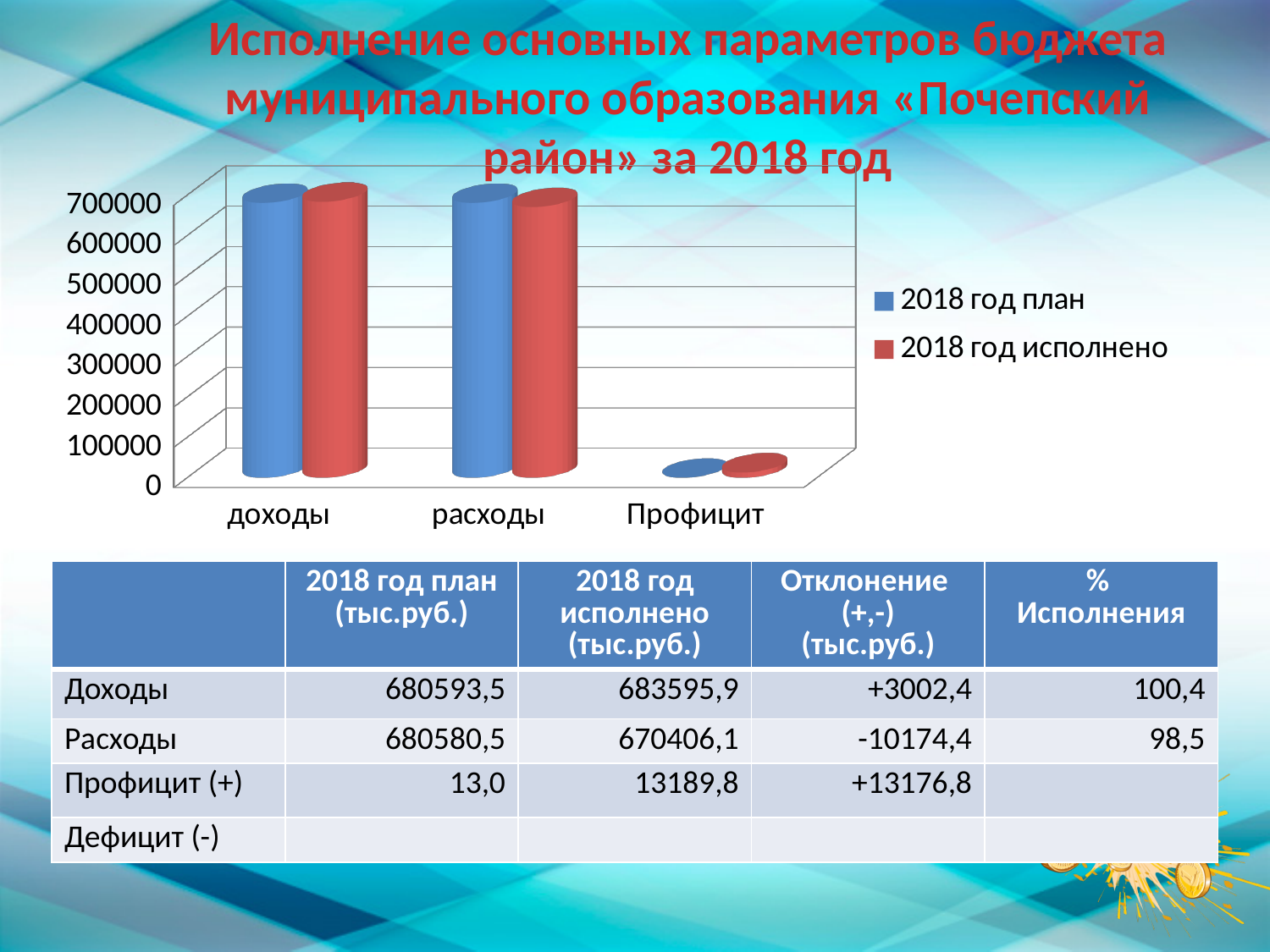
Which category has the lowest values in the chart? Профицит What colour are the bars for the series 2018 год исполнено? red Which is larger in the chart: the 2018 год план value for расходы or for Профицит? расходы How many series does the chart legend list? 2 According to the table on the slide, what is the 2018 год исполнено value for Расходы (тыс.руб.)? 670406,1 According to the table on the slide, what is the 2018 год план value for Доходы (тыс.руб.)? 680593,5 Is the value for доходы (2018 год план) greater or less than 600000? greater What kind of chart is shown on the slide? bar chart According to the table on the slide, what is the 2018 год исполнено value for Профицит (тыс.руб.)? 13189,8 Is the value for Профицит (2018 год исполнено) greater or less than 100000? less How many categories are shown on the x axis of the chart? 3 According to the table on the slide, what is the difference between the 2018 год исполнено and 2018 год план values for Доходы (тыс.руб.)? 3002,4